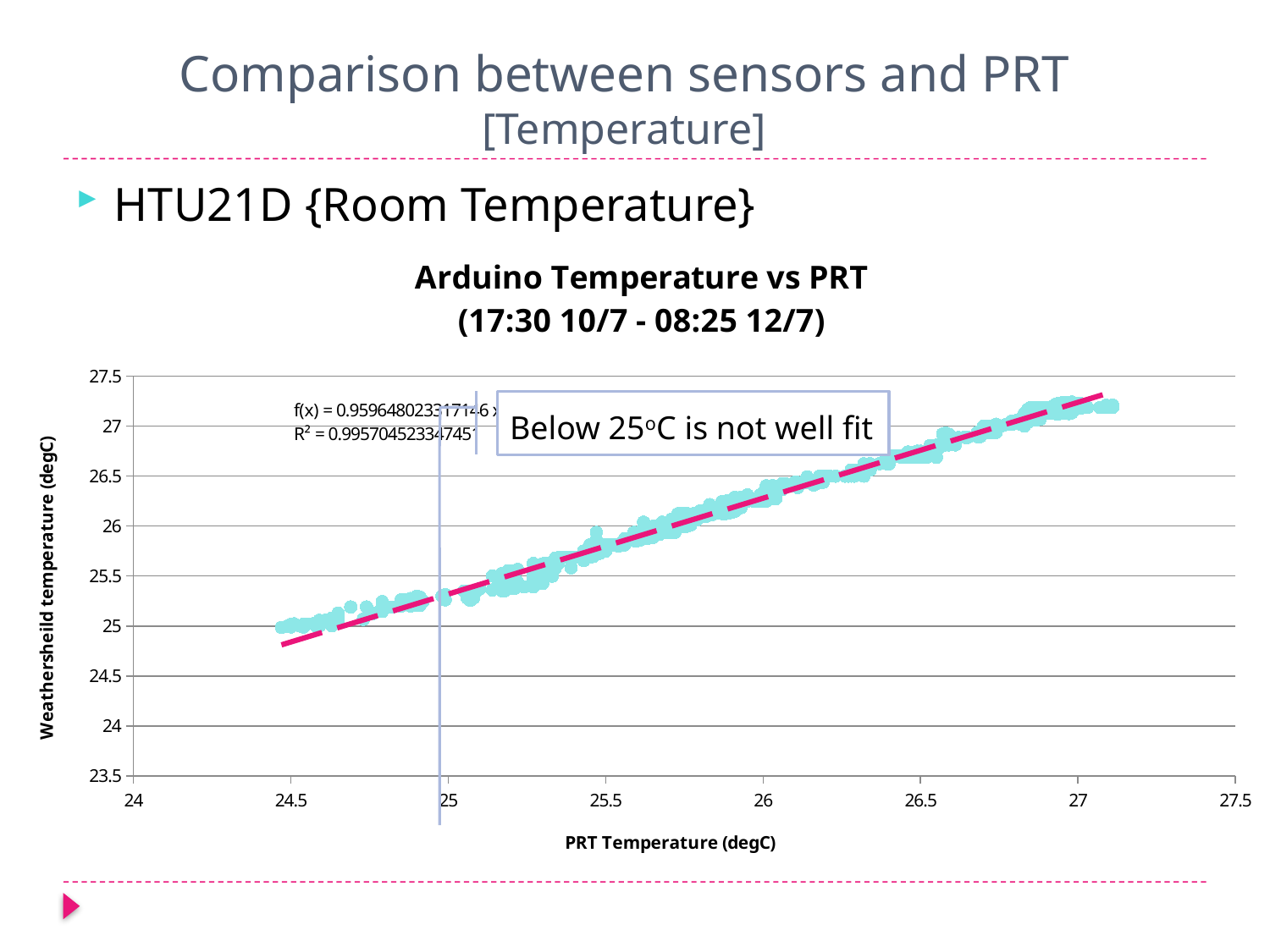
At a PRT temperature of 27 degC, is the Weathershield temperature greater or less than 27? greater Which is larger: the Weathershield temperature at a PRT temperature of 27 degC or at 25 degC? At 27 degC Do the plotted Weathershield temperature values rise or fall as PRT temperature increases along the x axis? Rise What is the highest value shown on the y axis of the chart? 27.5 At a PRT temperature of 26 degC, is the Weathershield temperature greater or less than 26? greater What is the title of the chart? Arduino Temperature vs PRT (17:30 10/7 - 08:25 12/7) What is the label of the y axis? Weathersheild temperature (degC) At a PRT temperature of 26.5 degC, is the Weathershield temperature greater or less than 26.5? greater What kind of chart is shown on the slide? Scatter chart